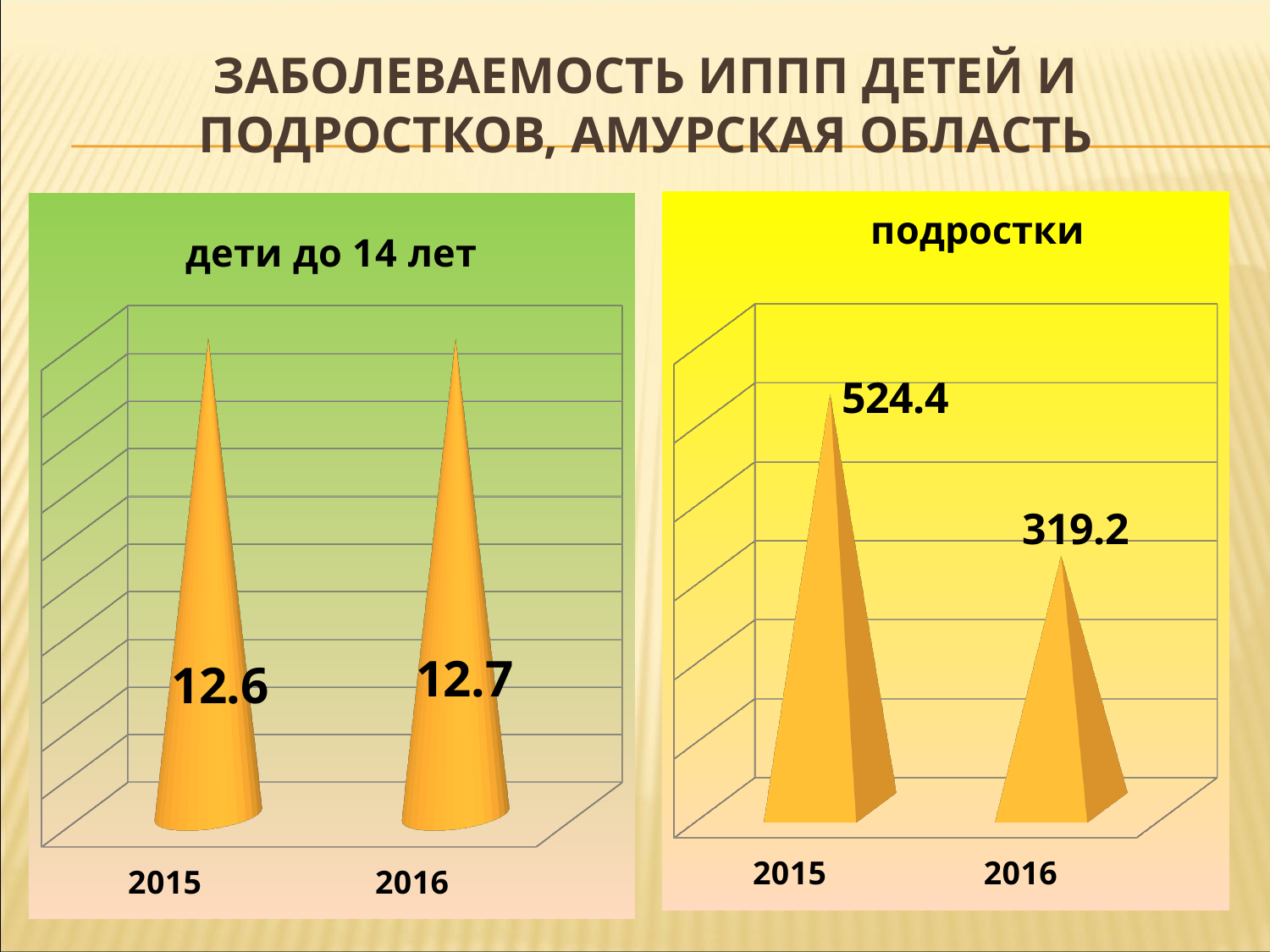
In the chart titled "подростки", what is the value for 2016? 319.2 In the chart titled "подростки", which is larger, the value for 2015 or the value for 2016? 2015 In the chart titled "подростки", what is the difference between the 2015 and 2016 values? 205.2 In the chart titled "подростки", what is the value for 2015? 524.4 How many categories are shown in the chart titled "подростки"? 2 In the chart titled "подростки", do the values rise or fall from 2015 to 2016? fall In the chart titled "дети до 14 лет", what is the difference between the 2016 and 2015 values? 0.1 In the chart titled "дети до 14 лет", what is the value for 2016? 12.7 In the chart titled "подростки", which year has the highest value? 2015 In the chart titled "дети до 14 лет", what is the value for 2015? 12.6 What kind of chart is the chart titled "дети до 14 лет"? bar chart In the chart titled "дети до 14 лет", which year has the lowest value? 2015